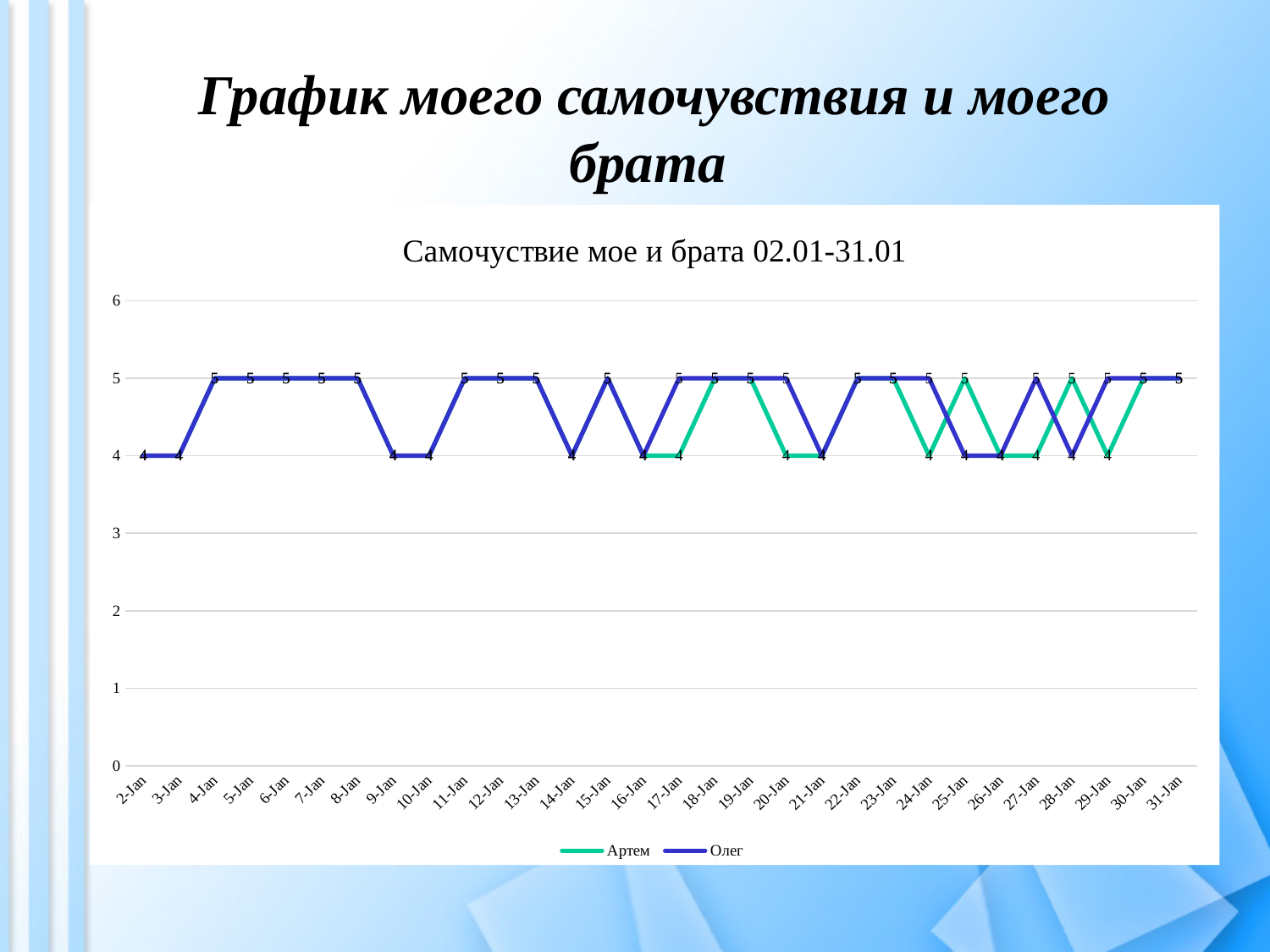
What is the value for Олег on 17-Jan? 5 What is the value for Артем on 17-Jan? 4 What are the names of the two series in the legend? Артем and Олег What is the title of the chart? Самочуствие мое и брата 02.01-31.01 What is the value for Артем on 5-Jan? 5 What is the difference between the values of Олег and Артем on 20-Jan? 1 How many series does the legend list? 2 On 25-Jan, which series has the higher value, Артем or Олег? Артем What is the highest value reached by either series on the chart? 5 What is the value for Олег on 2-Jan? 4 How many dates are plotted along the x axis? 30 What kind of chart is shown on the slide? line chart